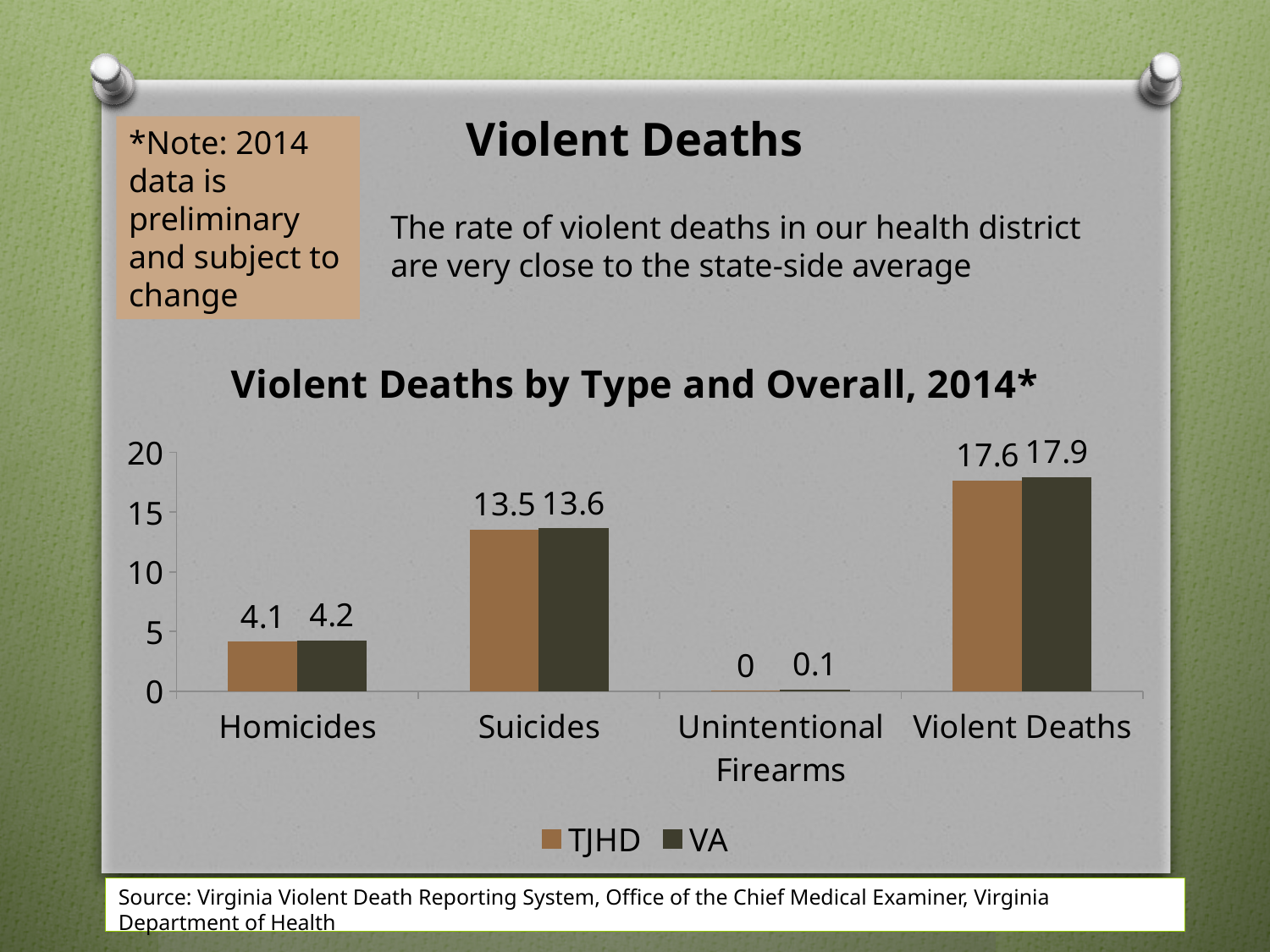
How many categories are shown on the x axis? 4 Which category has the lowest VA value? Unintentional Firearms Which category has the highest TJHD value? Violent Deaths What is the difference between the VA and TJHD values for Violent Deaths? 0.3 What is the TJHD value for Suicides? 13.5 What kind of chart is shown on the slide? bar chart Which is larger: the TJHD value for Suicides or the TJHD value for Homicides? Suicides Is the VA value for Suicides greater or less than 10? greater What is the TJHD value for Unintentional Firearms? 0 What is the VA value for Violent Deaths? 17.9 How many series does the legend list? 2 What is the VA value for Homicides? 4.2